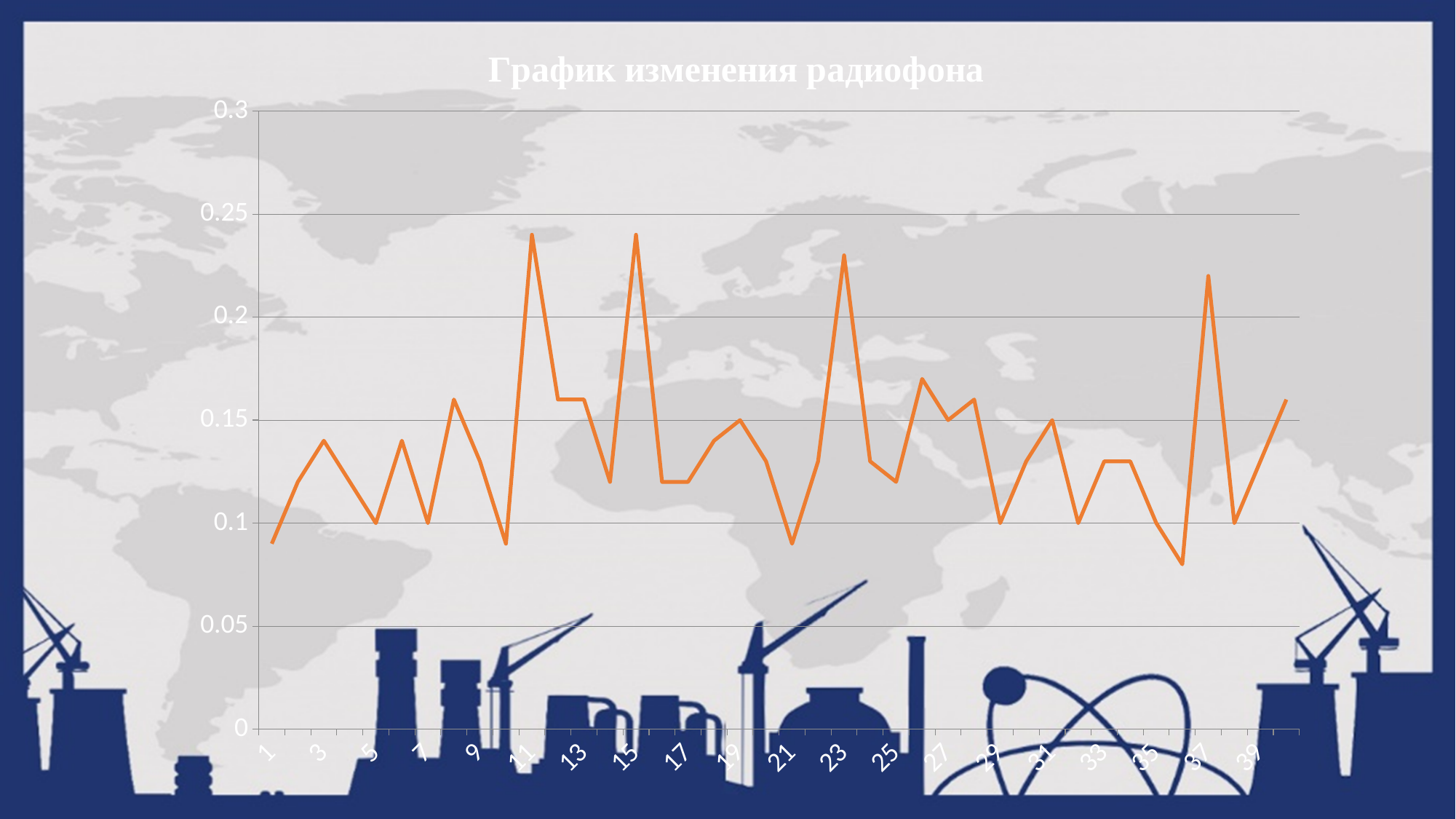
Is the value at point 24 greater or less than 0.2? less Is the value at point 38 greater or less than 0.2? less Is the value at point 9 greater or less than 0.15? less What kind of chart is shown on the slide? line chart What is the title of the chart? График изменения радиофона Which has the larger value, point 27 or point 30? point 27 Which has the larger value, point 9 or point 5? point 9 What is the highest value shown on the vertical axis of the chart? 0.3 Does the line rise or fall from point 11 to point 12? fall